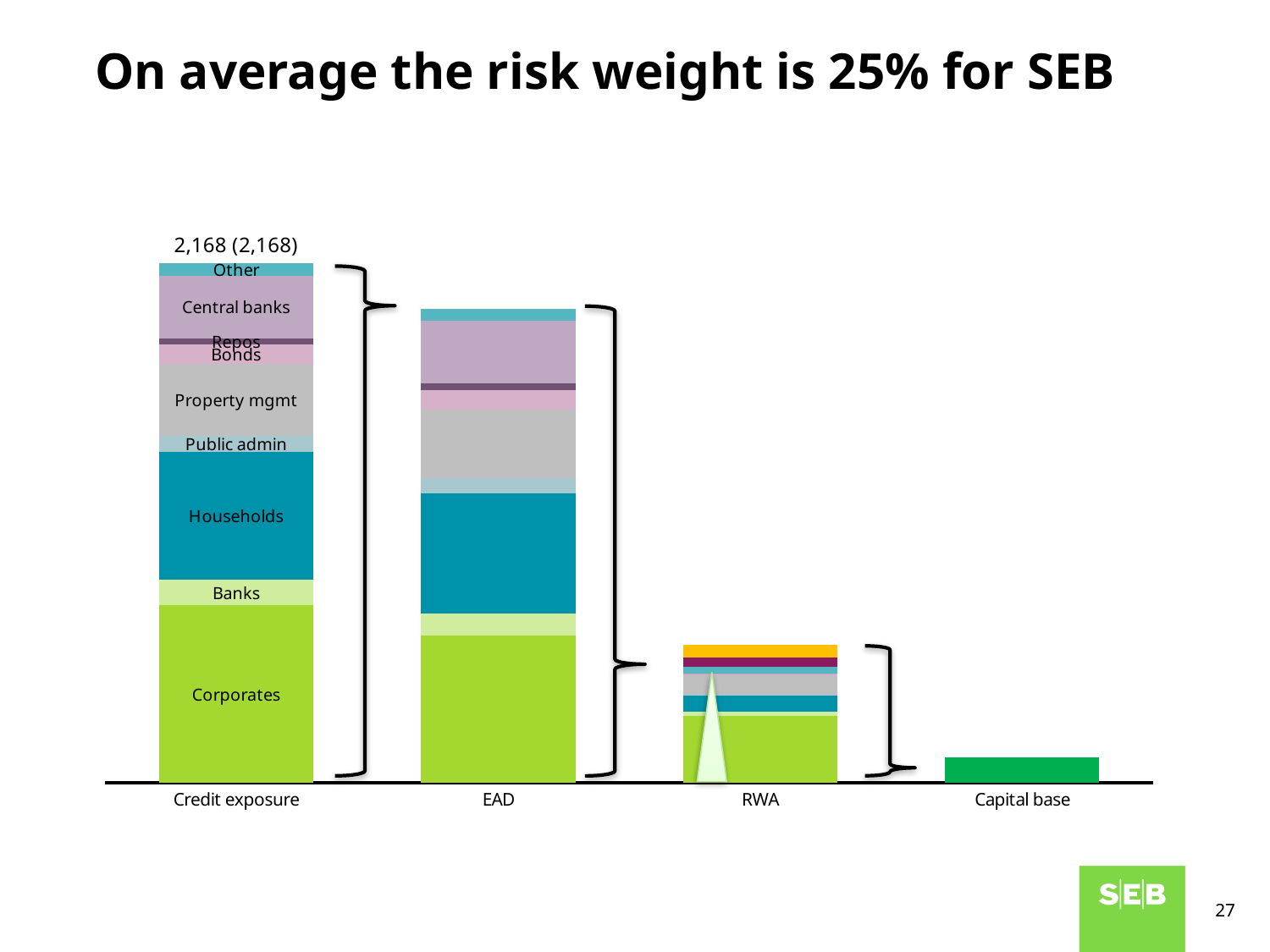
What value is printed above the Credit exposure bar? 2,168 (2,168) Do the bar heights rise or fall from left to right across the x axis? Fall Which bar is taller, RWA or Capital base? RWA Which category has the tallest bar? Credit exposure Which bar is taller, EAD or RWA? EAD How many categories are shown along the x axis of the chart? 4 What is the title of the slide? On average the risk weight is 25% for SEB Which category has the shortest bar? Capital base Which segment is at the top of the Credit exposure bar? Other Which bar is taller, Credit exposure or EAD? Credit exposure What kind of chart is shown on the slide? Stacked bar chart Which segment is the largest within the Credit exposure bar? Corporates